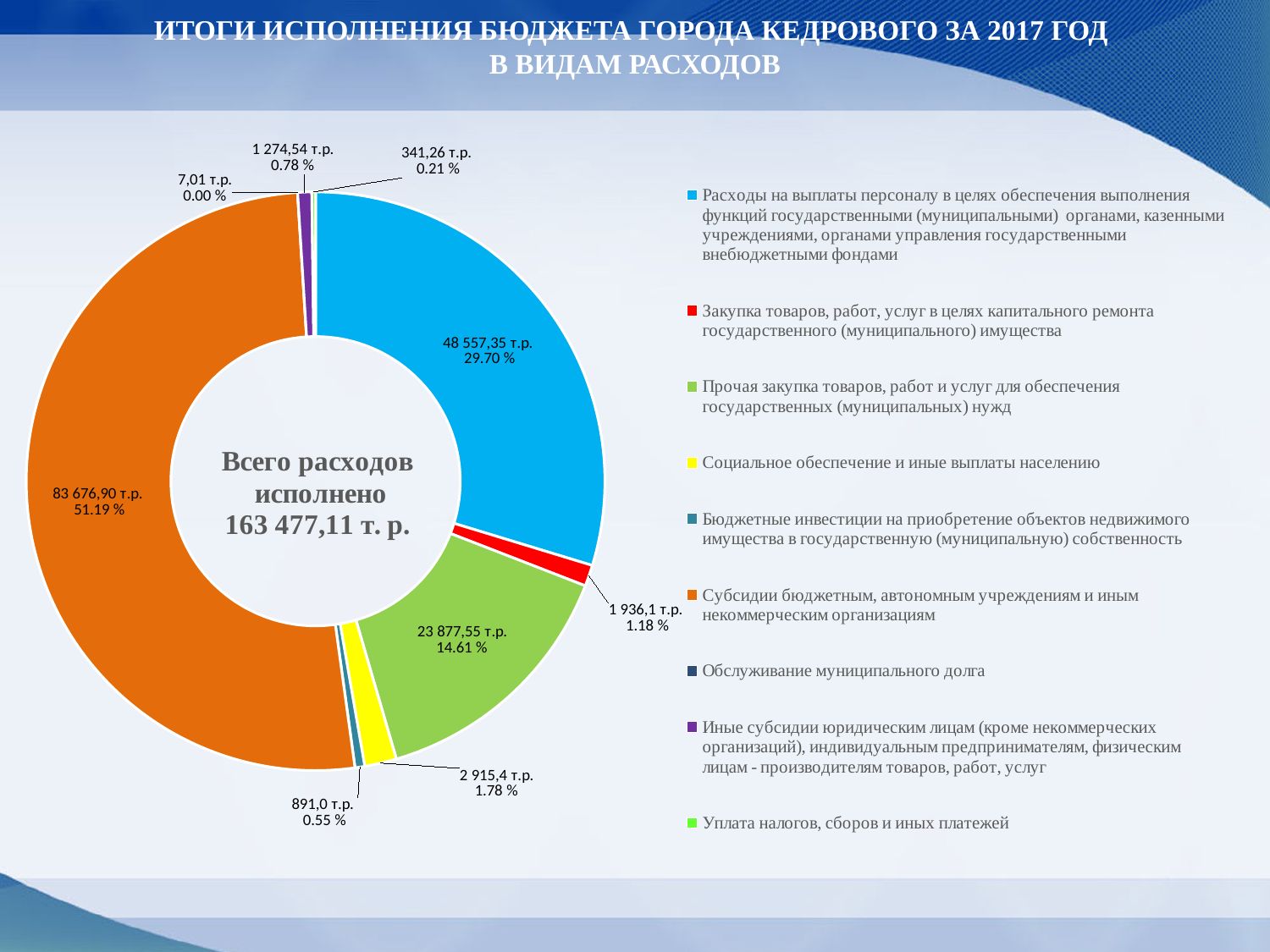
What is the total of all expenditures shown in the centre of the chart? 163 477,11 т. р. Which category has the smallest slice? Обслуживание муниципального долга How many categories does the legend list? 9 What share of the total does "Расходы на выплаты персоналу..." (the blue slice) represent? 29.70 % What is the value for "Уплата налогов, сборов и иных платежей"? 341,26 т.р. What kind of chart is shown on the slide? Doughnut (pie) chart What colour is the slice for "Иные субсидии юридическим лицам..."? Purple Which category has the largest slice? Субсидии бюджетным, автономным учреждениям и иным некоммерческим организациям Which is larger: "Закупка товаров, работ, услуг в целях капитального ремонта" or "Социальное обеспечение и иные выплаты населению"? Социальное обеспечение и иные выплаты населению What is the value for "Прочая закупка товаров, работ и услуг для обеспечения государственных (муниципальных) нужд"? 23 877,55 т.р. What is the value for "Субсидии бюджетным, автономным учреждениям и иным некоммерческим организациям"? 83 676,90 т.р. What share does "Социальное обеспечение и иные выплаты населению" represent? 1.78 %